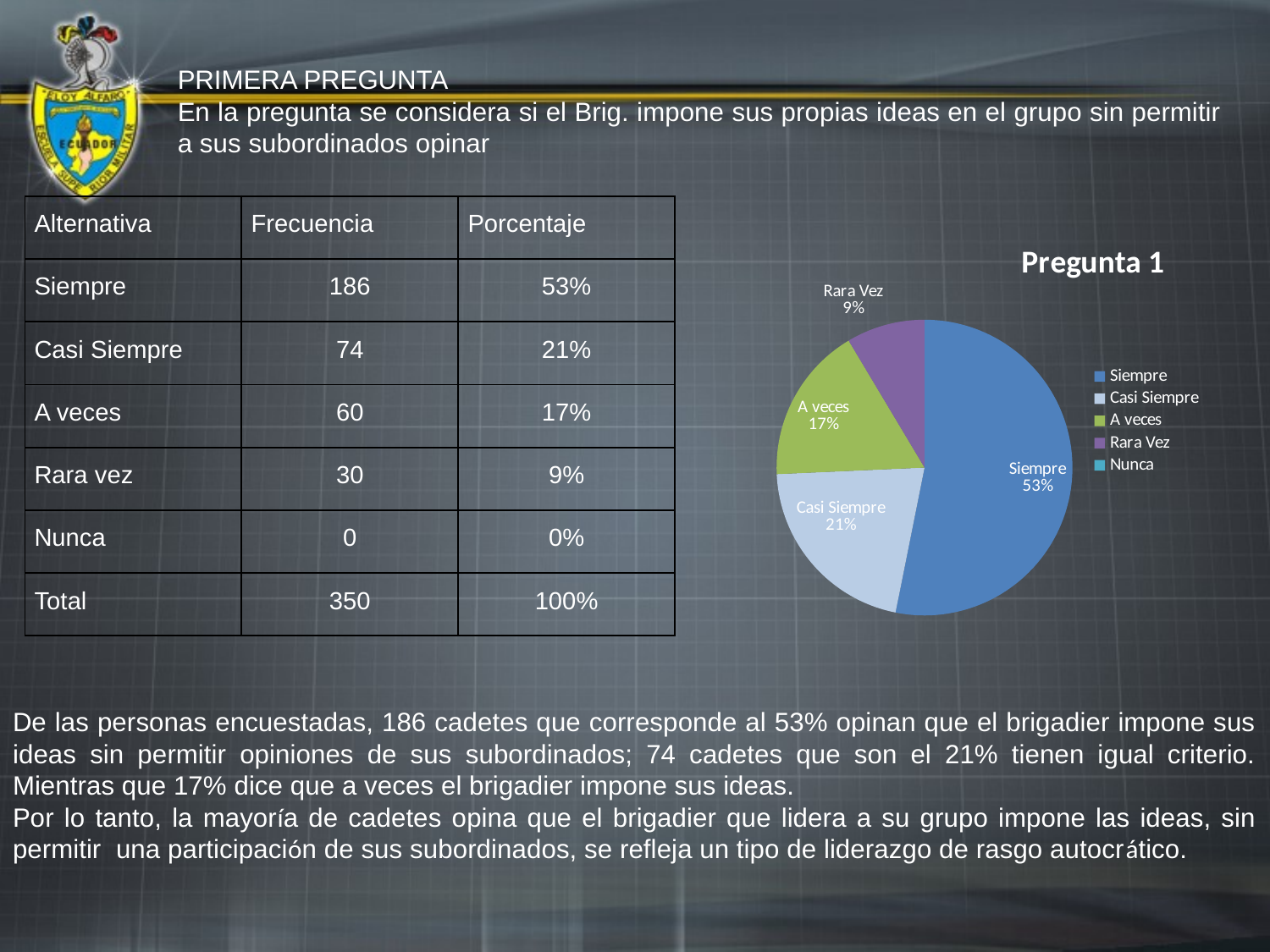
Which category has the largest slice in the pie chart? Siempre What percentage does the Siempre slice show in the pie chart? 53% How many entries does the legend of the pie chart list? 5 What is the difference in percentage points between the Siempre and Casi Siempre slices? 32 What percentage does the Rara Vez slice show in the pie chart? 9% What is the combined share of the Casi Siempre and A veces slices? 38% Which slice is larger, A veces or Rara Vez? A veces What percentage does the Casi Siempre slice show in the pie chart? 21% Among the labelled slices, which category has the smallest share in the pie chart? Rara Vez What type of chart is shown on the slide? pie chart What percentage does the A veces slice show in the pie chart? 17% What is the title of the chart? Pregunta 1